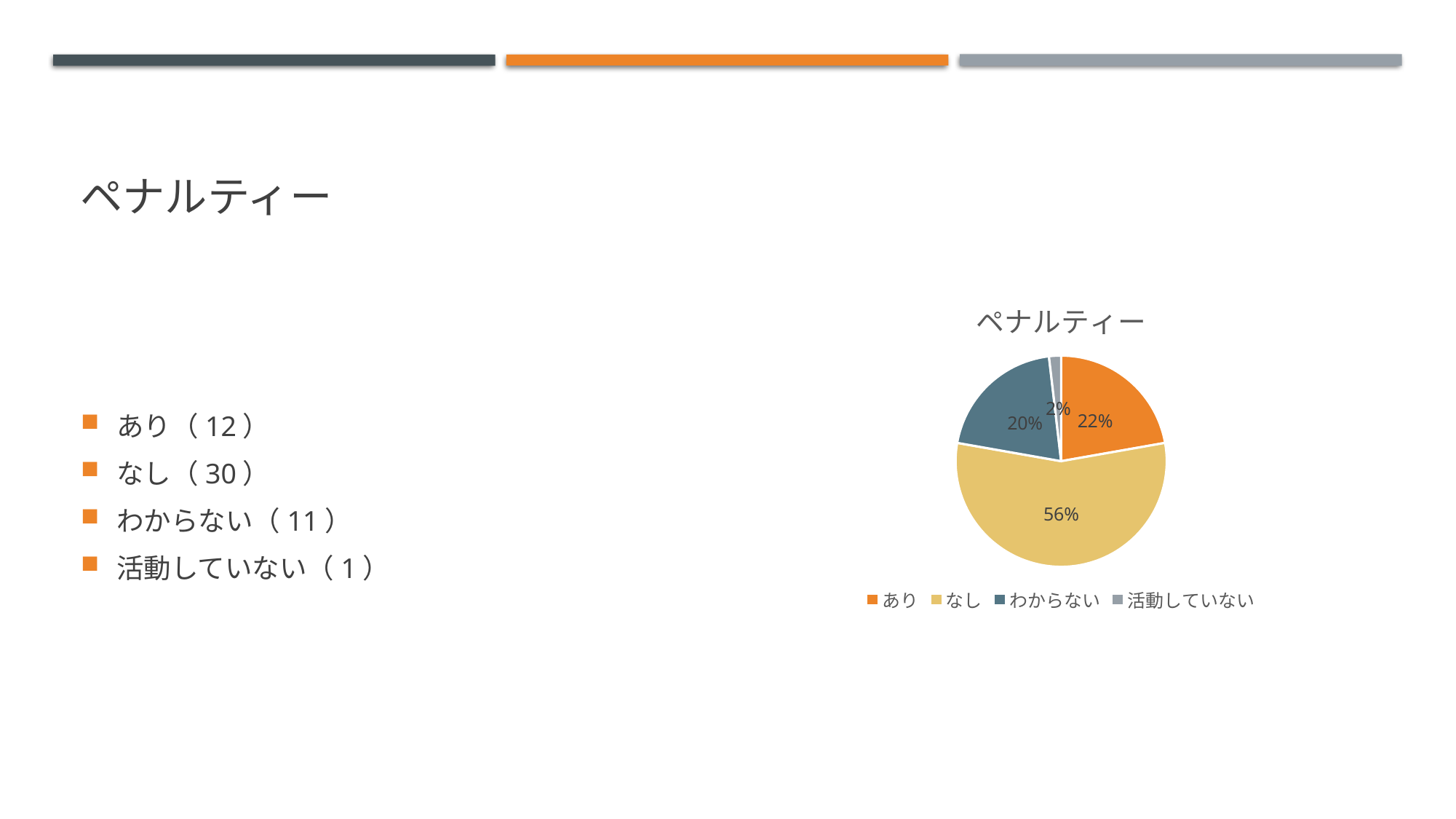
What type of chart is shown on the slide? pie chart What percentage does the なし slice show? 56% How many slices does the pie chart have? 4 What is the difference in percentage points between the なし slice and the あり slice? 34 Which category has the smallest share of the pie? 活動していない Which category has the largest share of the pie? なし Which is larger, the share for あり or the share for わからない? あり What is the title of the chart? ペナルティー What percentage does the 活動していない slice show? 2% What percentage does the わからない slice show? 20% What percentage does the あり slice show? 22% How many entries does the legend list? 4